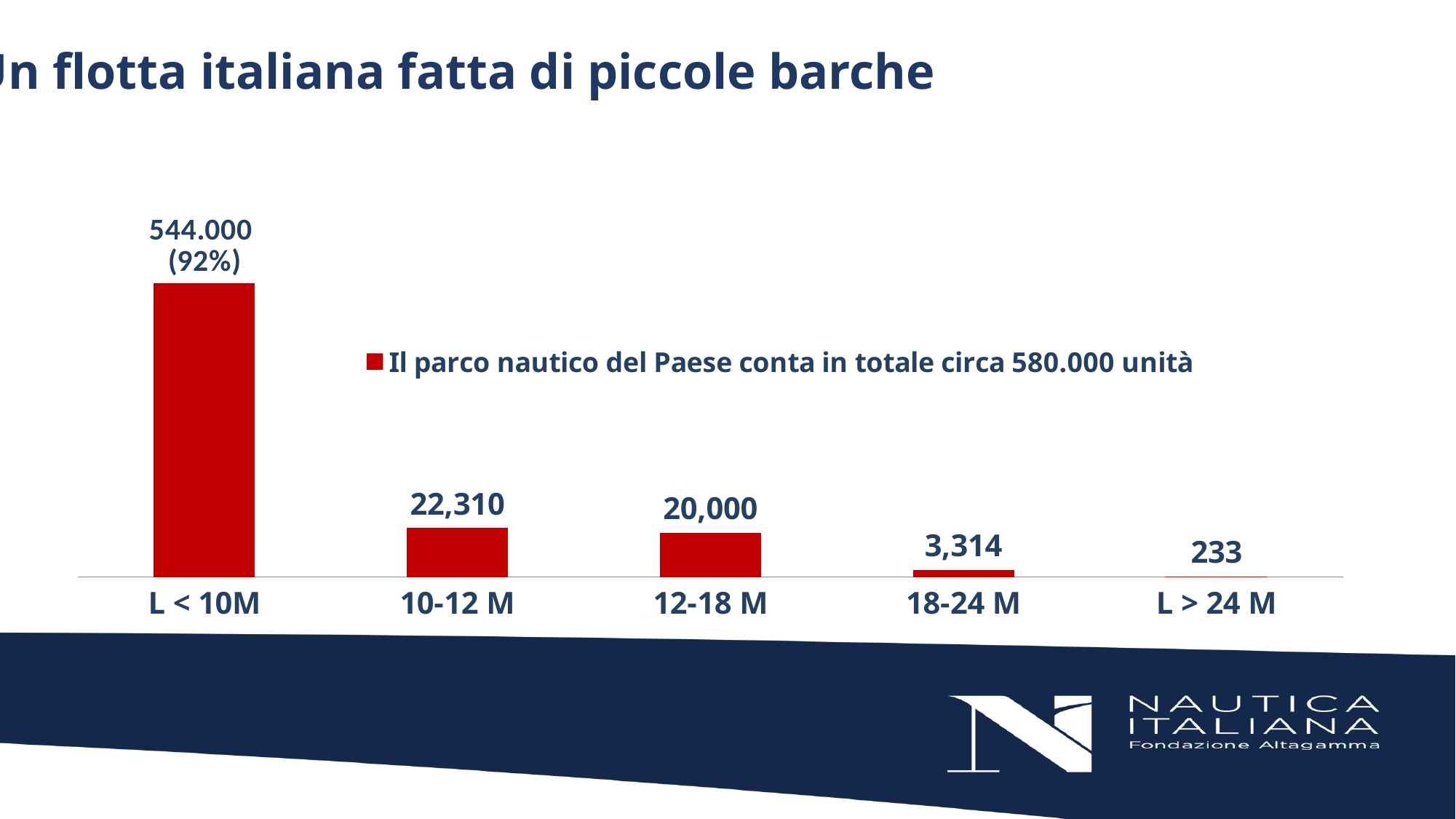
What is the difference between the values for 18-24 M and L > 24 M? 3,081 What kind of chart is shown on the slide? Bar chart What is the value for the L < 10M category? 544.000 (92%) What is the value for the 10-12 M category? 22,310 What is the value for the 18-24 M category? 3,314 Which category has the lowest value? L > 24 M What is the value for the 12-18 M category? 20,000 Which is larger, the value for 10-12 M or the value for 12-18 M? 10-12 M How many categories are shown on the x axis? 5 Which category has the highest value? L < 10M What is the difference between the values for 10-12 M and 12-18 M? 2,310 What is the value for the L > 24 M category? 233